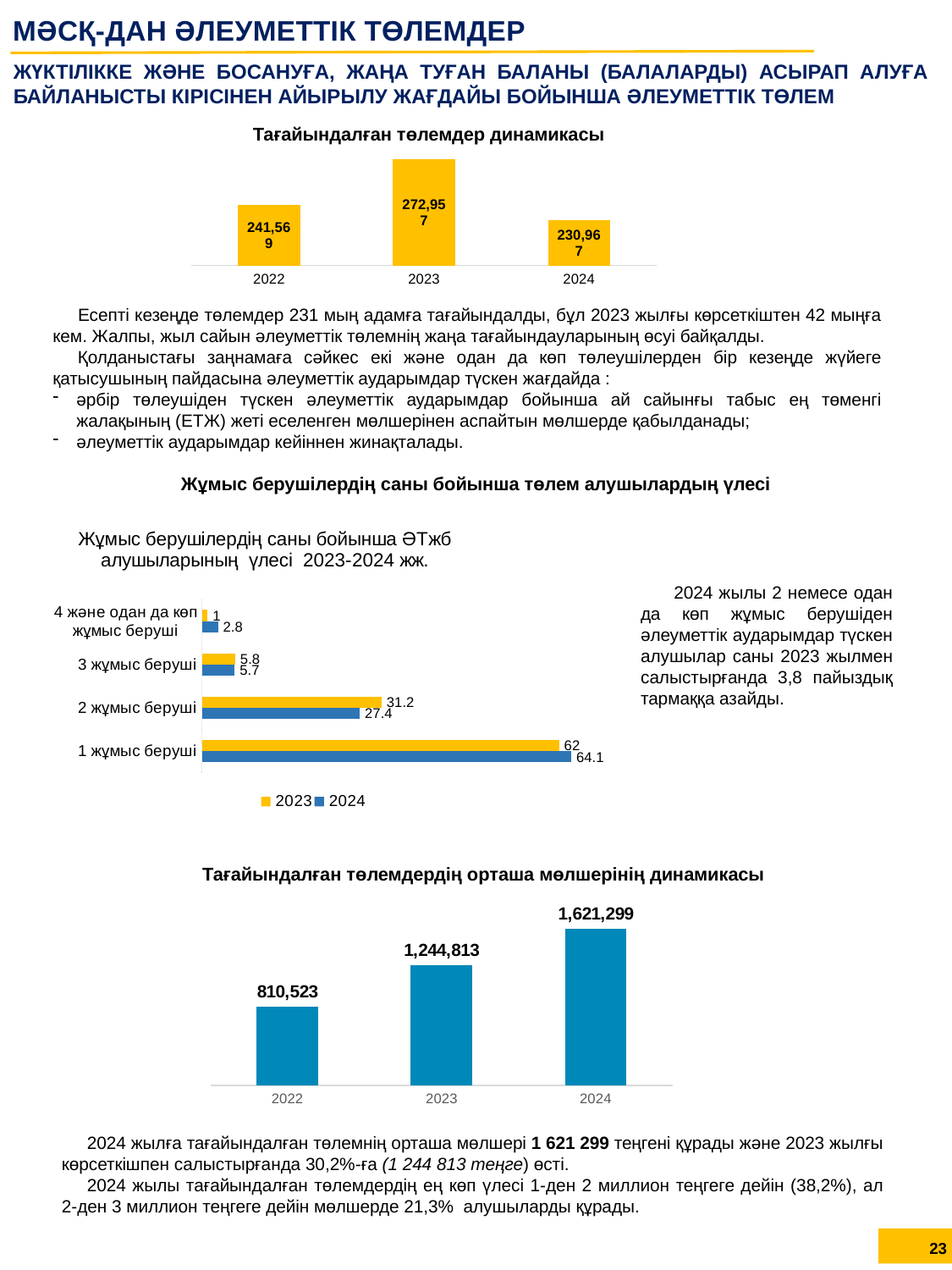
In the chart 'Жұмыс берушілердің саны бойынша ӘТжб алушыларының үлесі 2023-2024 жж.', which is larger for '4 және одан да көп жұмыс беруші': the 2023 value or the 2024 value? 2024 In the chart 'Тағайындалған төлемдердің орташа мөлшерінің динамикасы', what is the difference between the 2024 and 2023 values? 376,486 In the chart 'Тағайындалған төлемдердің орташа мөлшерінің динамикасы', do the values rise or fall from 2022 to 2024? Rise In the chart 'Тағайындалған төлемдердің орташа мөлшерінің динамикасы', what is the value for 2022? 810,523 In the chart 'Тағайындалған төлемдер динамикасы', what is the difference between the 2023 and 2024 values? 41,990 In the chart 'Жұмыс берушілердің саны бойынша ӘТжб алушыларының үлесі 2023-2024 жж.', what is the 2023 value for '1 жұмыс беруші'? 62 In the chart 'Тағайындалған төлемдер динамикасы', how many years are shown? 3 In the chart 'Жұмыс берушілердің саны бойынша ӘТжб алушыларының үлесі 2023-2024 жж.', what kind of chart is it? Bar chart In the chart 'Тағайындалған төлемдер динамикасы', what is the value for 2023? 272,957 In the chart 'Тағайындалған төлемдер динамикасы', which year has the lowest value? 2024 In the chart 'Жұмыс берушілердің саны бойынша ӘТжб алушыларының үлесі 2023-2024 жж.', what is the 2024 value for '2 жұмыс беруші'? 27.4 In the chart 'Жұмыс берушілердің саны бойынша ӘТжб алушыларының үлесі 2023-2024 жж.', how many series does the legend list? 2